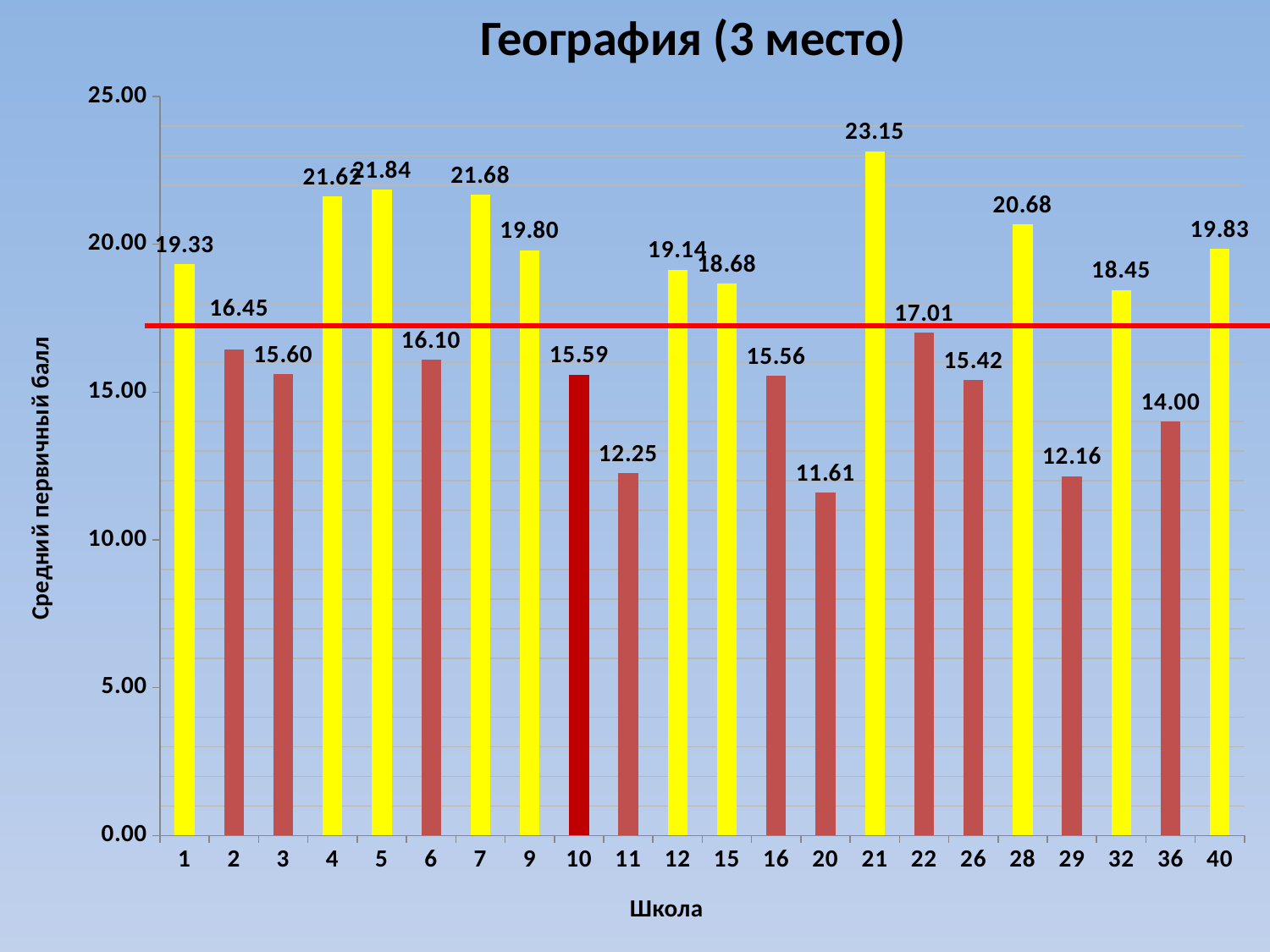
Which school has the highest average primary score? 21 What is the difference between the values for school 21 and school 20? 11.54 Which has a higher value, school 28 or school 32? School 28 Is the value for school 36 greater or less than 15.00? less What is the value shown for school 40? 19.83 What is the difference between the values for school 40 and school 1? 0.50 How many schools are shown on the x axis? 22 Which school has the lowest average primary score? 20 Which school's bar is coloured dark red? 10 What is the average primary score for school 21? 23.15 What is the value shown for school 10? 15.59 What kind of chart is shown on the slide? Bar chart